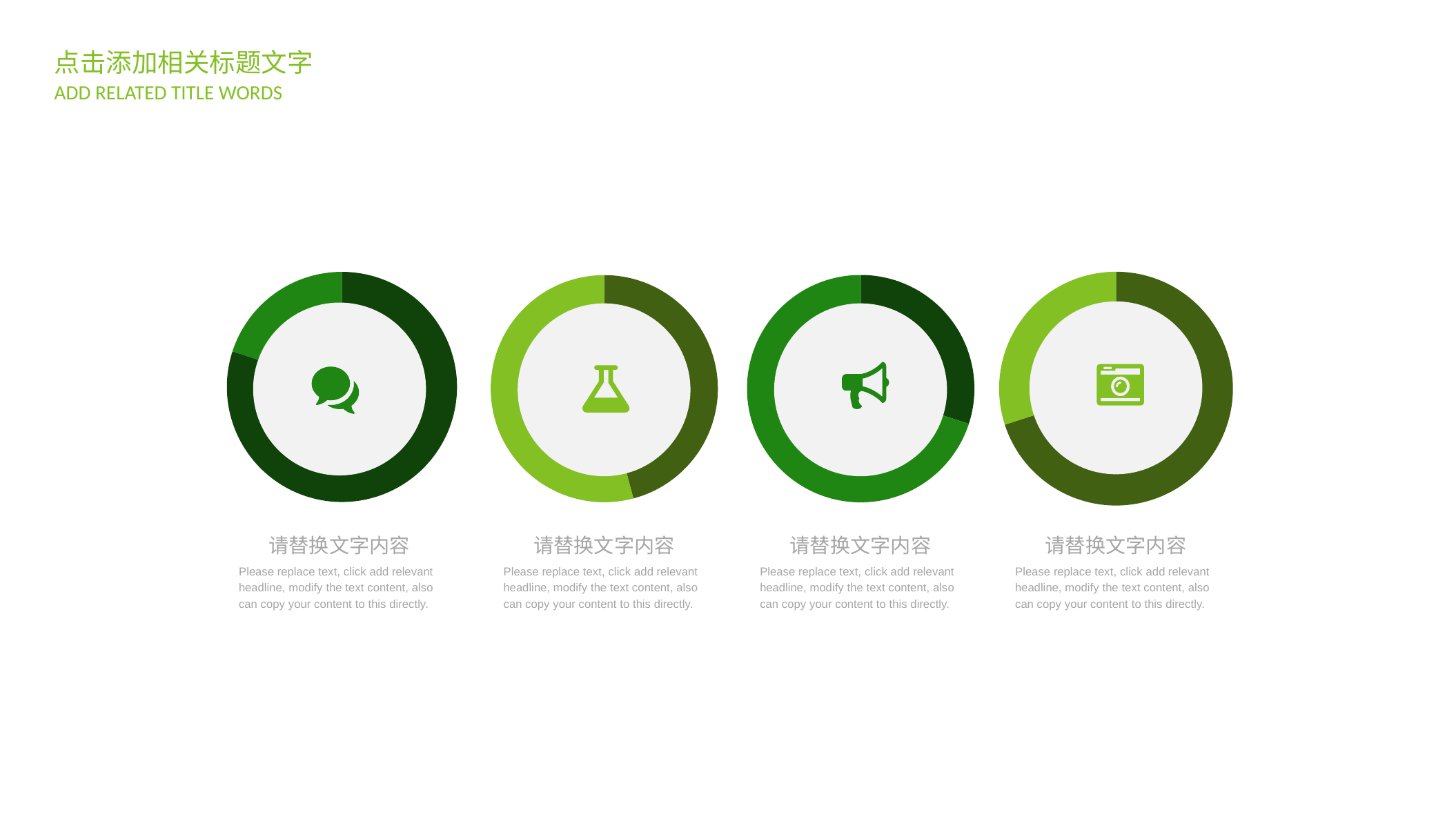
In the second donut chart from the left, which segment is larger, the light green one or the dark olive one? The light green one How many donut charts are shown on the slide? 4 In the rightmost donut chart, which segment is larger, the light green one or the dark olive one? The dark olive one What icon is shown in the centre of the second donut chart from the left? A flask How many segments does the leftmost donut chart have? 2 Does the leftmost donut chart show any data labels with values? No In the third donut chart from the left, which segment is larger, the medium green one or the dark green one? The medium green one What kind of chart is the leftmost chart on the slide? Donut chart How many segments does the second donut chart from the left have? 2